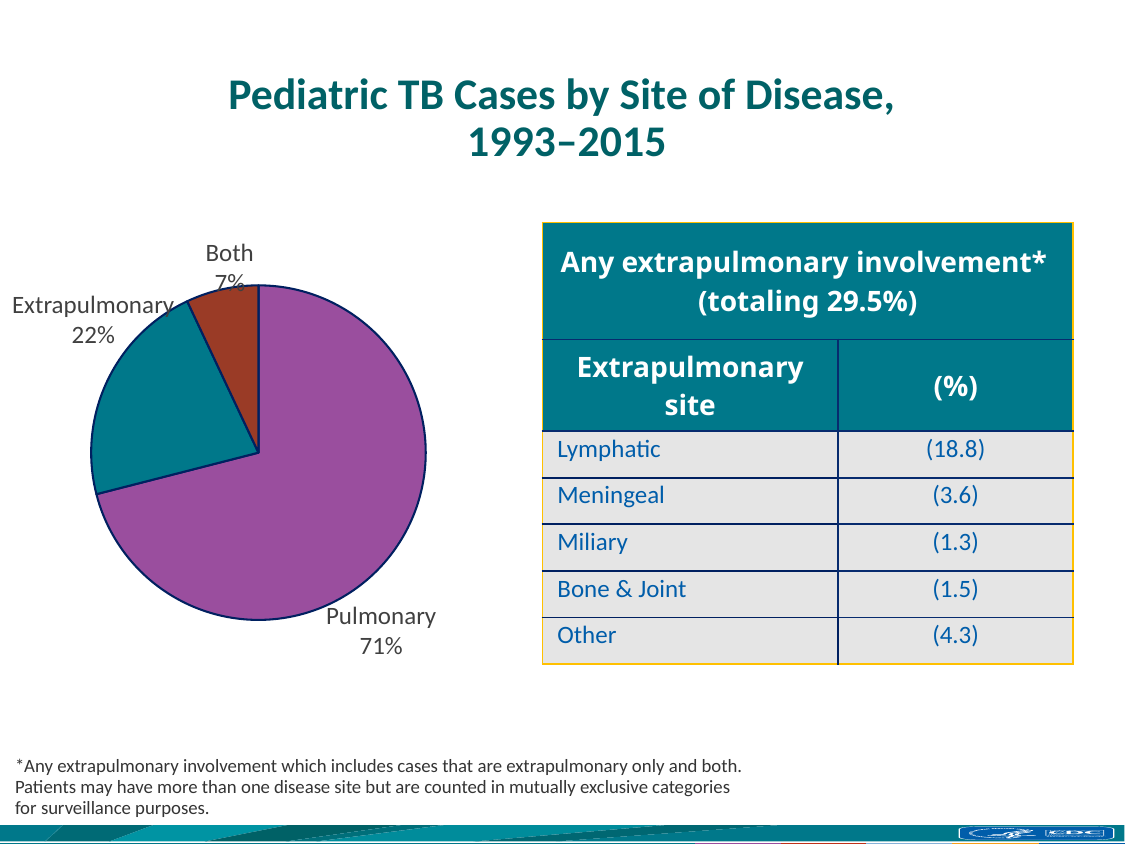
Which site of disease has the smallest slice in the pie chart? Both What is the difference in percentage points between the Extrapulmonary and Both slices? 15 What share of pediatric TB cases is Pulmonary in the pie chart? 71% Which slice is larger, Extrapulmonary or Both? Extrapulmonary Which site of disease has the largest slice in the pie chart? Pulmonary What is the title of the slide containing the pie chart? Pediatric TB Cases by Site of Disease, 1993–2015 What share of pediatric TB cases is Extrapulmonary in the pie chart? 22% What kind of chart is shown on the slide? pie chart What colour is the Pulmonary slice in the pie chart? purple How many slices does the pie chart have? 3 What share of pediatric TB cases is labelled Both in the pie chart? 7% What is the difference in percentage points between the Pulmonary and Extrapulmonary slices? 49